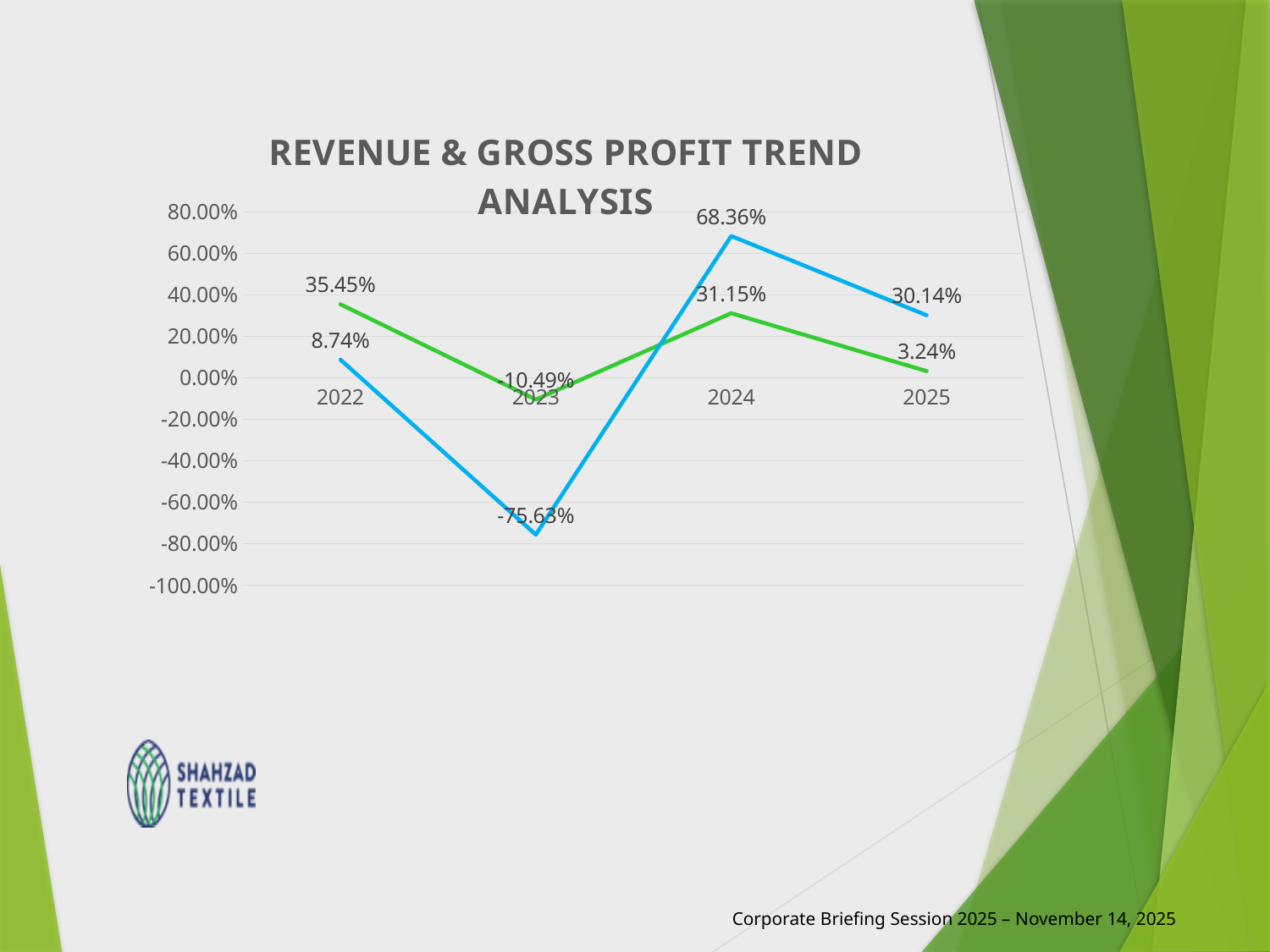
What is the title of the chart? REVENUE & GROSS PROFIT TREND ANALYSIS What type of chart is shown on the slide? line chart Which line has the higher value in 2022, the green line or the blue line? green line What is the difference between the blue line's value in 2024 and its value in 2025? 38.22% In which year does the blue line reach its highest value? 2024 In which year does the green line reach its lowest value? 2023 What is the value of the blue line in 2023? -75.63% What is the value of the blue line in 2024? 68.36% What is the value of the green line in 2022? 35.45% Does the blue line rise or fall from 2024 to 2025? fall How many years are plotted along the x axis? 4 What is the value of the green line in 2025? 3.24%